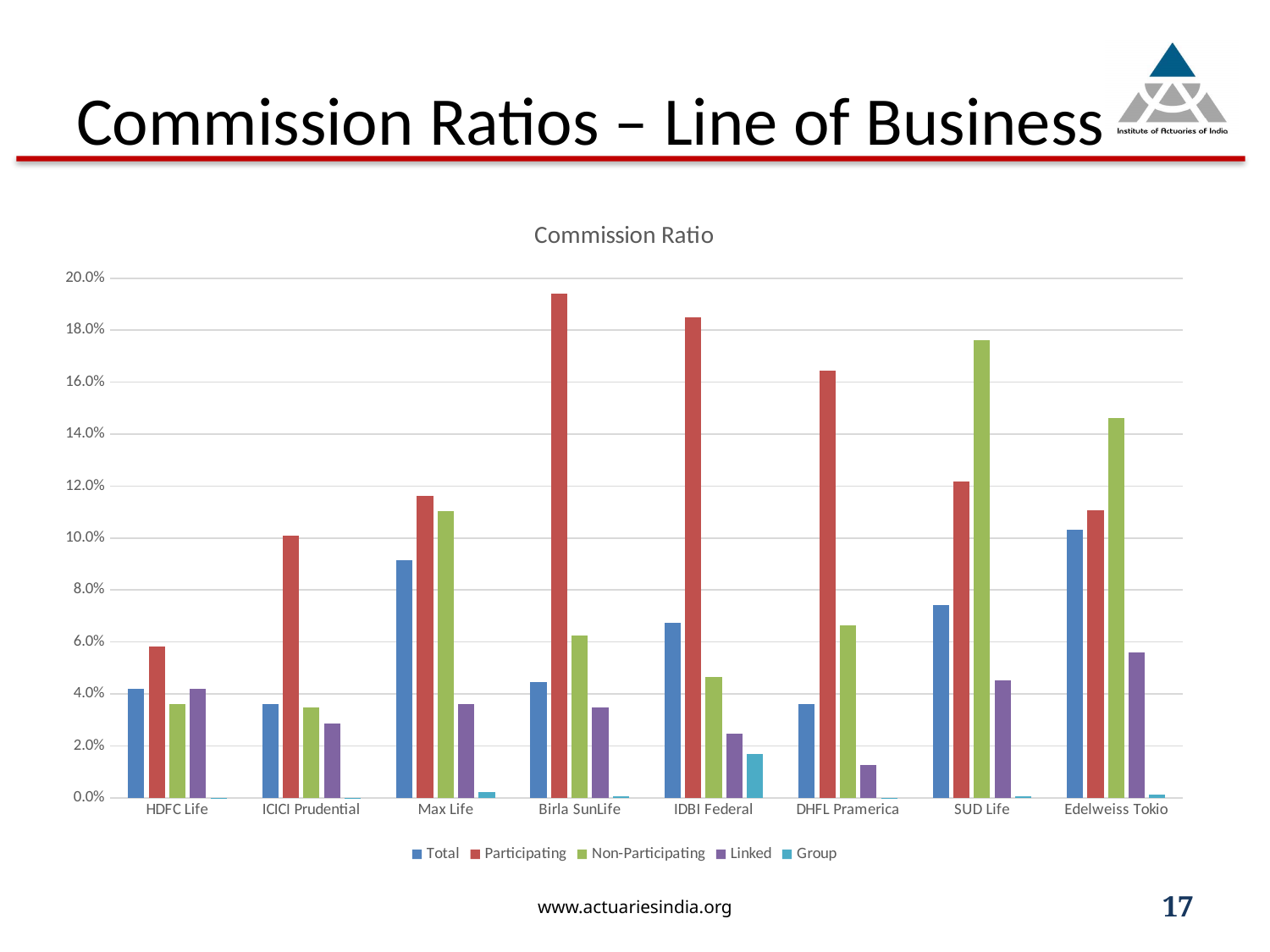
What is the title of the chart? Commission Ratio Is the Total value for Max Life greater or less than 8.0%? greater How many series does the chart's legend list? 5 Which company has the highest Non-Participating commission ratio? SUD Life For Edelweiss Tokio, which is larger: the Participating or the Non-Participating commission ratio? Non-Participating What kind of chart is shown on the slide? bar chart Is the Participating value for IDBI Federal greater or less than 16.0%? greater How many companies are shown along the x axis of the chart? 8 Which company has the lowest Linked commission ratio? DHFL Pramerica Which company has the highest Total commission ratio? Edelweiss Tokio Which company has the larger Participating commission ratio: HDFC Life or ICICI Prudential? ICICI Prudential Which company has the highest Participating commission ratio? Birla SunLife